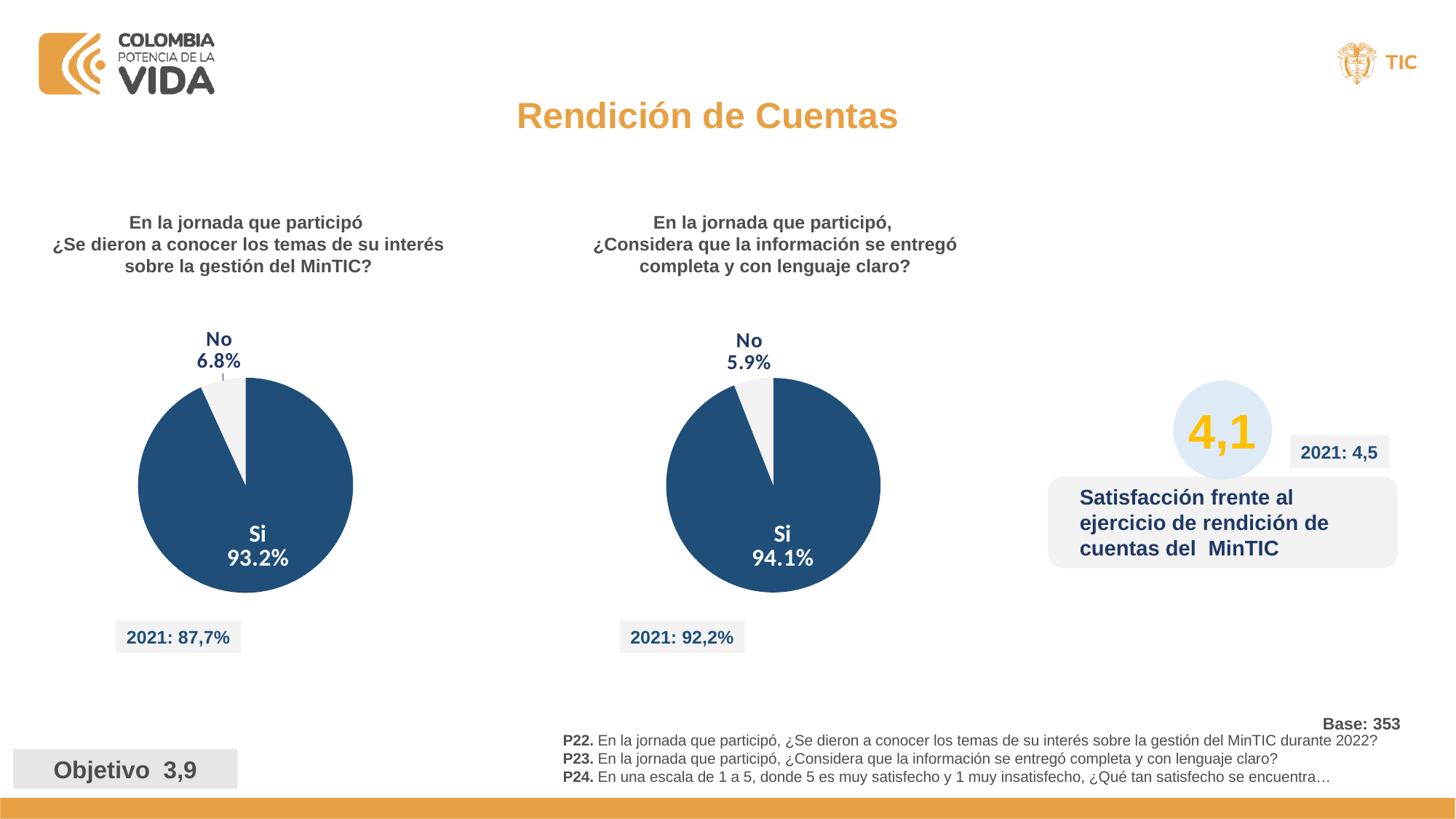
In the left pie chart (¿Se dieron a conocer los temas de su interés sobre la gestión del MinTIC?), what is the difference between the 'Si' and 'No' shares? 86.4% In the left pie chart (¿Se dieron a conocer los temas de su interés sobre la gestión del MinTIC?), what share is labelled 'Si'? 93.2% In the right pie chart (¿Considera que la información se entregó completa y con lenguaje claro?), what share is labelled 'No'? 5.9% In the right pie chart (¿Considera que la información se entregó completa y con lenguaje claro?), which slice is the smallest? No What kind of chart is the left chart, titled 'En la jornada que participó ¿Se dieron a conocer los temas de su interés sobre la gestión del MinTIC?'? Pie chart How many pie charts are shown on the slide? 2 In the right pie chart (¿Considera que la información se entregó completa y con lenguaje claro?), what is the difference between the 'Si' and 'No' shares? 88.2% In the left pie chart (¿Se dieron a conocer los temas de su interés sobre la gestión del MinTIC?), which slice is the largest? Si In the right pie chart (¿Considera que la información se entregó completa y con lenguaje claro?), what share is labelled 'Si'? 94.1% How many slices does the right pie chart (¿Considera que la información se entregó completa y con lenguaje claro?) have? 2 Which is larger: the 'Si' share in the left pie chart or the 'Si' share in the right pie chart? The right pie chart (94.1%) In the left pie chart (¿Se dieron a conocer los temas de su interés sobre la gestión del MinTIC?), what share is labelled 'No'? 6.8%